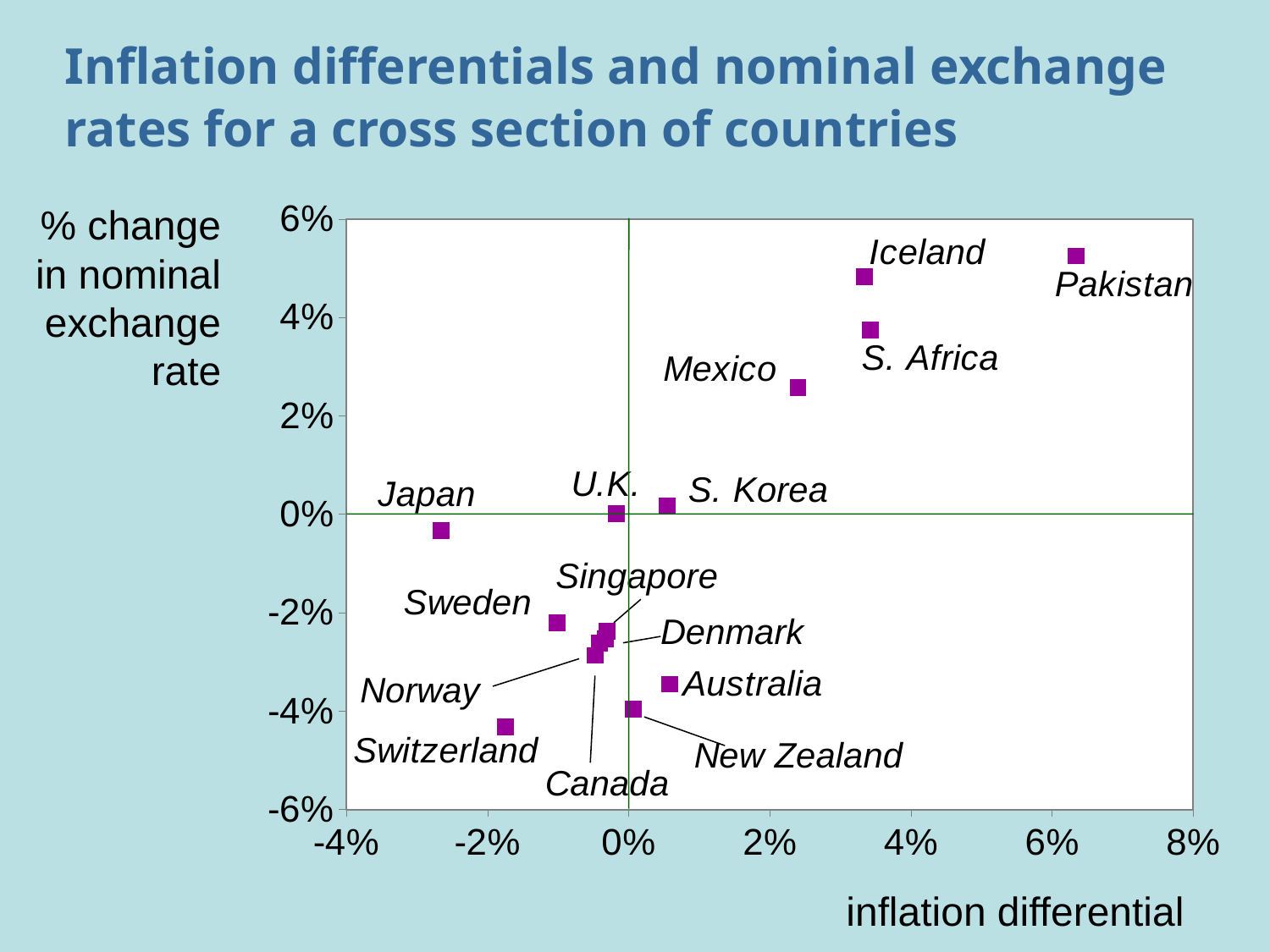
Is the % change in nominal exchange rate for Iceland greater or less than 4%? greater Which has the larger % change in nominal exchange rate, Iceland or Mexico? Iceland How many countries are plotted on the chart? 15 Which country has the lowest % change in nominal exchange rate? Switzerland What kind of chart is shown on the slide? Scatter chart Which country has the lowest inflation differential? Japan Which country has the highest % change in nominal exchange rate? Pakistan Is the inflation differential for Pakistan greater or less than 4%? greater Overall, does the % change in nominal exchange rate rise or fall as the inflation differential increases? rise Is the inflation differential for Japan greater or less than -2%? less What is the label of the horizontal axis? inflation differential